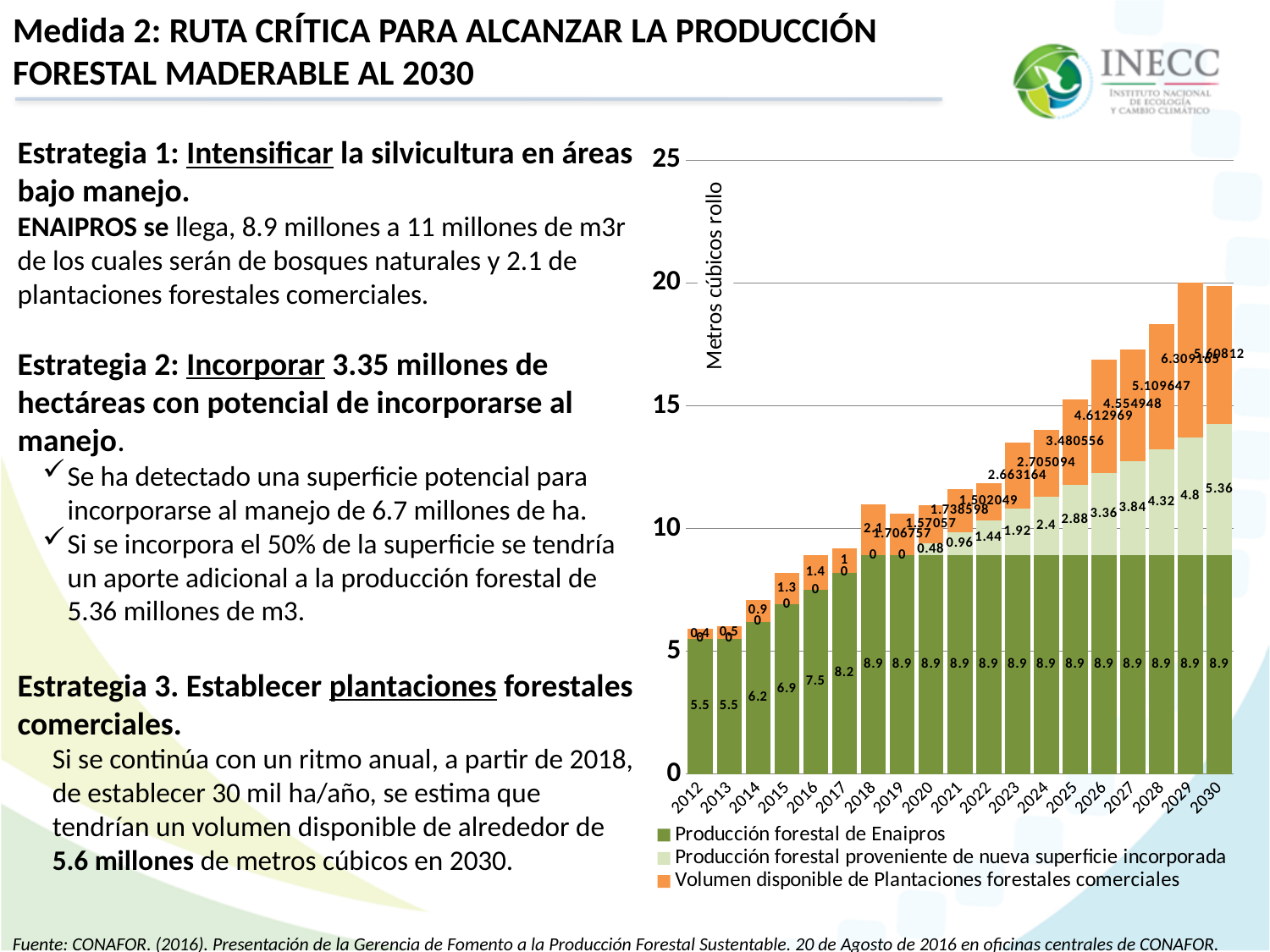
Is the total height of the stacked bar for 2030 greater or less than 15? greater What is the value of Producción forestal de Enaipros in 2012? 5.5 Which is larger, the Producción forestal de Enaipros value for 2012 or for 2017? 2017 Which year has the lowest total stacked bar? 2012 What is the value of Producción forestal proveniente de nueva superficie incorporada in 2030? 5.36 What is the label on the y axis of the chart? Metros cúbicos rollo What type of chart is shown on the slide? Stacked bar chart What is the value of Producción forestal proveniente de nueva superficie incorporada in 2020? 0.48 How many years are shown on the x axis of the chart? 19 What is the difference between the Producción forestal proveniente de nueva superficie incorporada values for 2030 and 2020? 4.88 What is the value of Producción forestal de Enaipros in 2030? 8.9 How many series does the chart legend list? 3